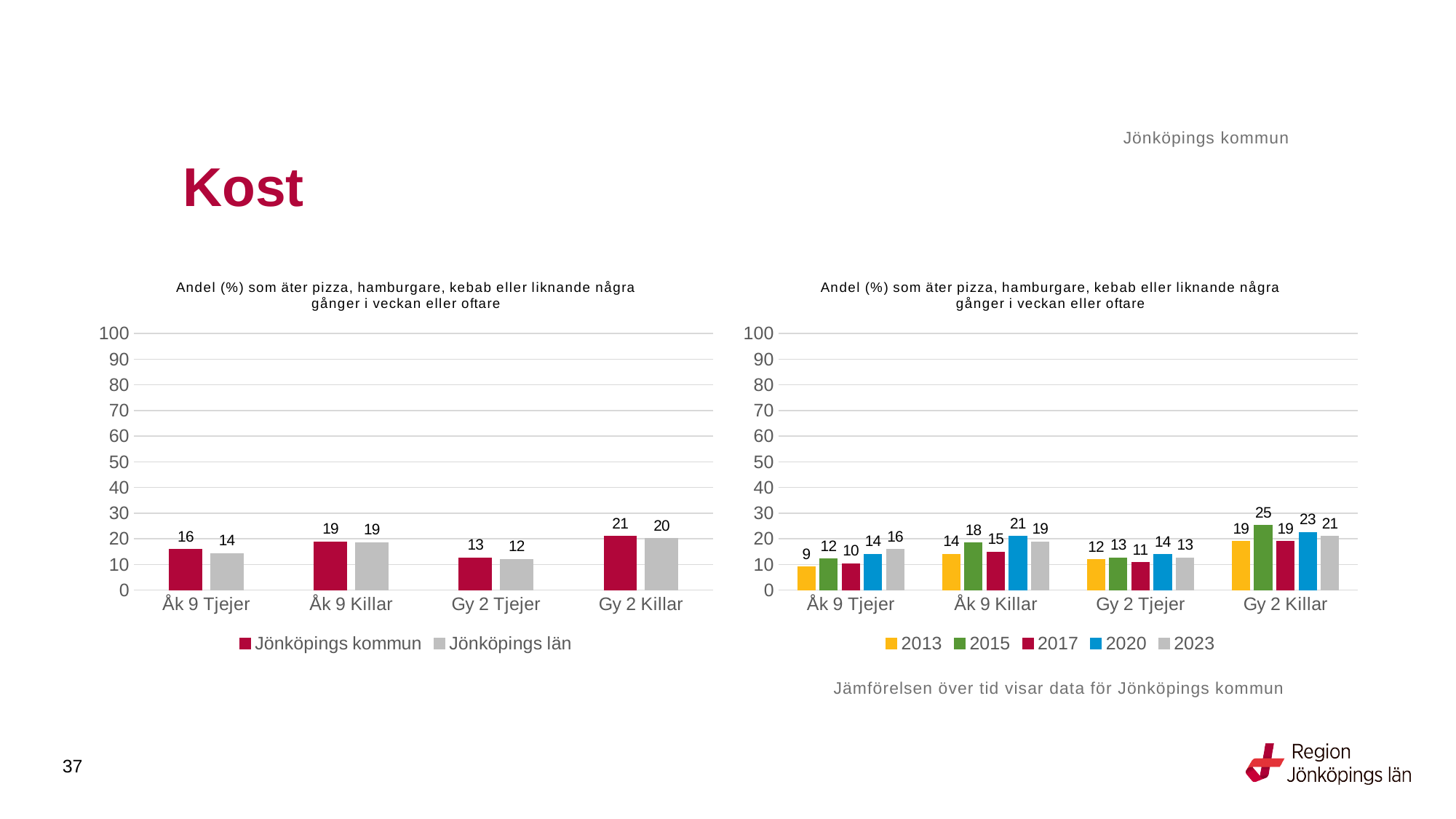
In the left chart, which category has the highest value for Jönköpings kommun? Gy 2 Killar In the left chart, which category has the lowest value for Jönköpings län? Gy 2 Tjejer In the left chart, how many series does the legend list? 2 In the right chart, what is the value for 2013 for Åk 9 Tjejer? 9 In the right chart, which year has the highest value for Gy 2 Killar? 2015 What kind of chart is the right chart? bar chart In the left chart, what is the value for Jönköpings kommun for Åk 9 Tjejer? 16 In the left chart, what is the difference between Jönköpings kommun and Jönköpings län for Åk 9 Tjejer? 2 In the right chart, what is the value for 2020 for Åk 9 Killar? 21 In the left chart, what is the value for Jönköpings län for Gy 2 Killar? 20 In the right chart, is the value for 2015 for Gy 2 Killar larger or smaller than the value for 2023 for Gy 2 Killar? larger In the right chart, how many series does the legend list? 5